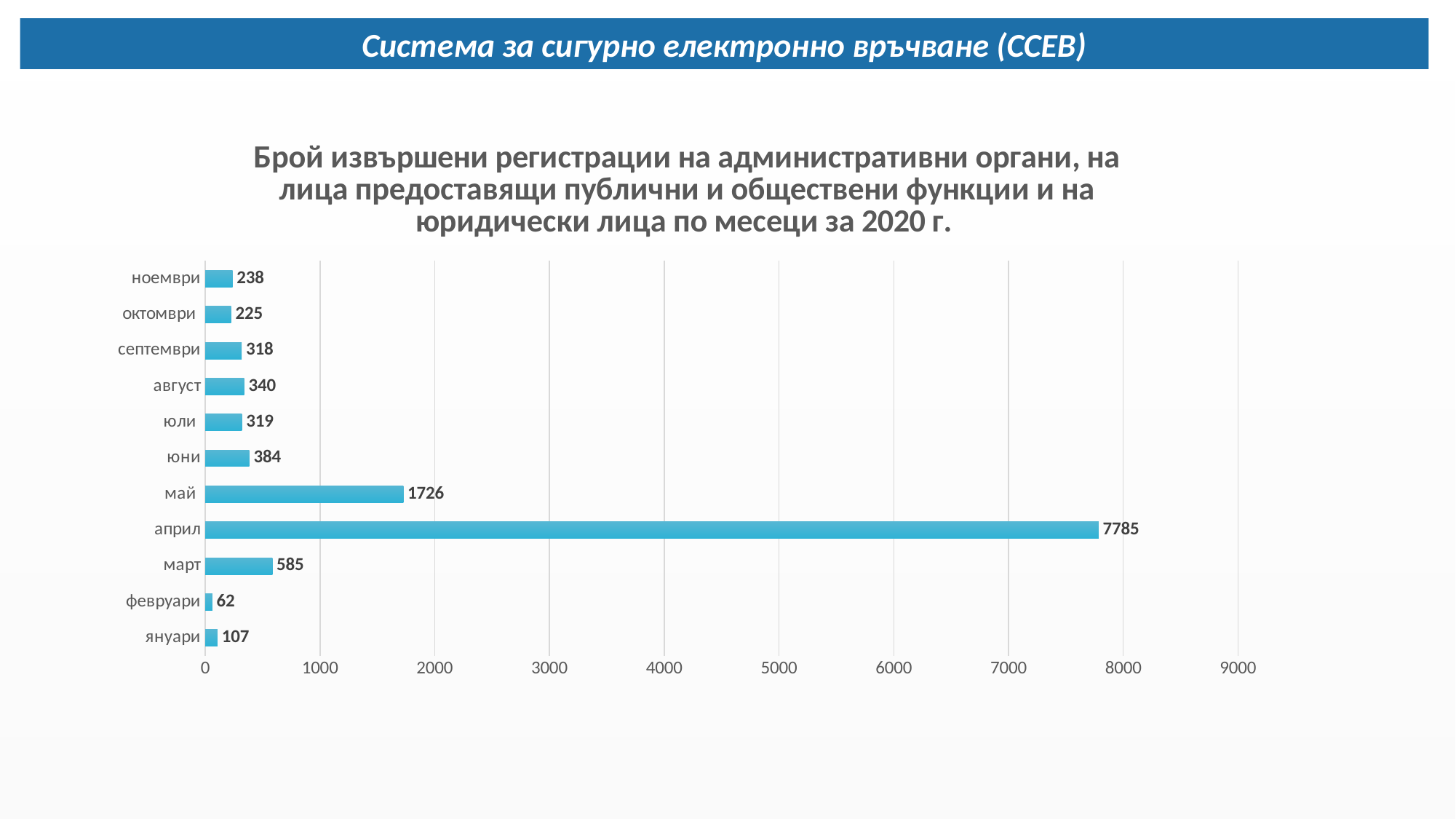
What is the difference between the values for март and януари? 478 Is the value for май greater or less than 2000? less What is the value for февруари (February)? 62 How many months are shown on the chart? 11 Which is larger, the value for юни or the value for юли? юни Which month has the highest value? април Which month has the lowest value? февруари What kind of chart is shown on the slide? bar chart What is the value for април (April)? 7785 What is the highest tick value shown on the horizontal axis? 9000 What is the difference between the values for април and май? 6059 What is the value for май (May)? 1726